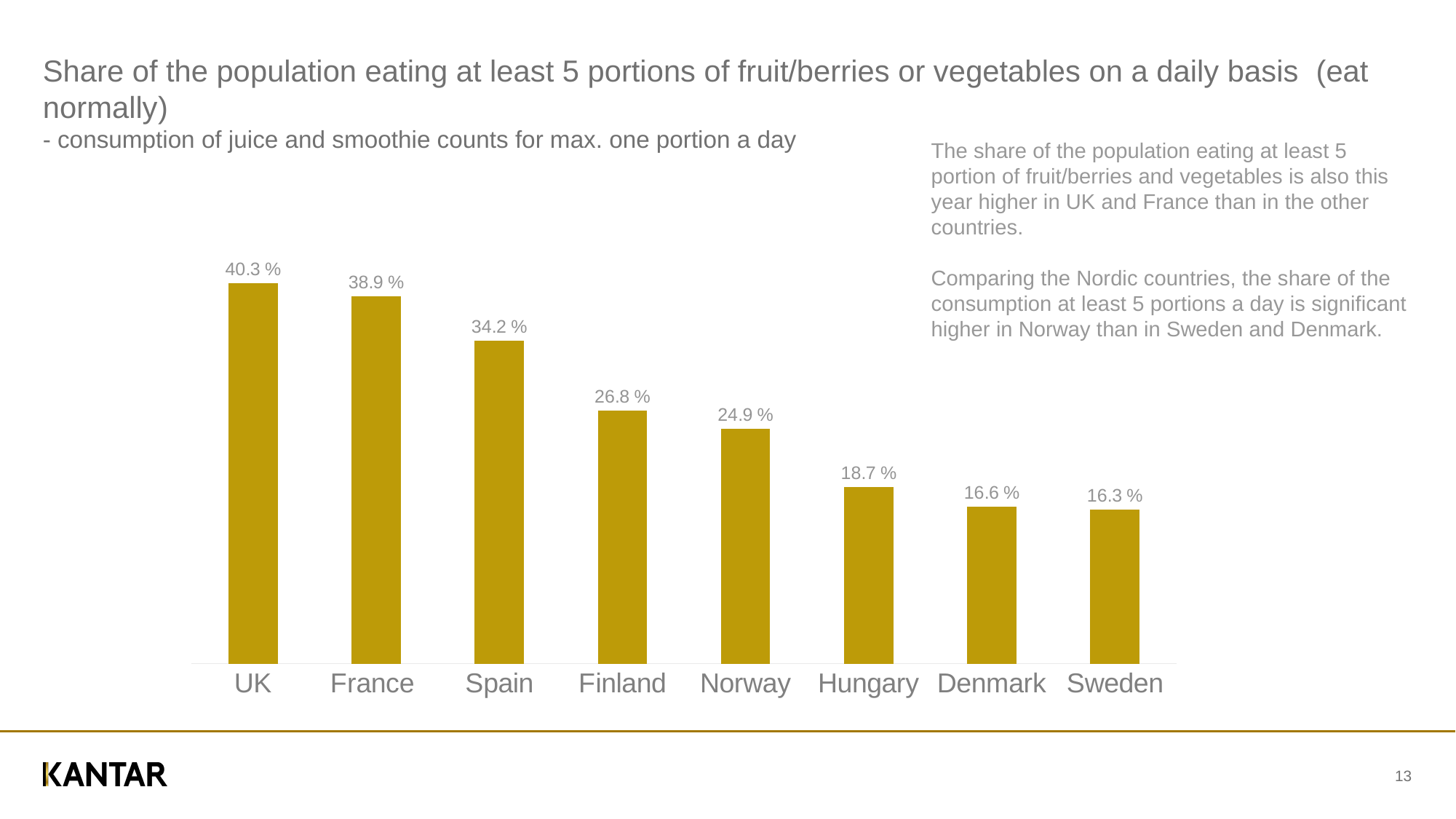
What kind of chart is shown on the slide? Bar chart What is the value for Norway? 24.9 % Do the values rise or fall from left to right across the countries? Fall Which country has the lowest value? Sweden What is the difference between the values for Norway and Sweden? 8.6 % What is the difference between the values for the UK and France? 1.4 % Which has a larger value, Spain or Finland? Spain Which country has the highest value? UK What is the value for the UK? 40.3 % How many countries are shown in the chart? 8 Which has a larger value, Hungary or Norway? Norway What is the value for Denmark? 16.6 %